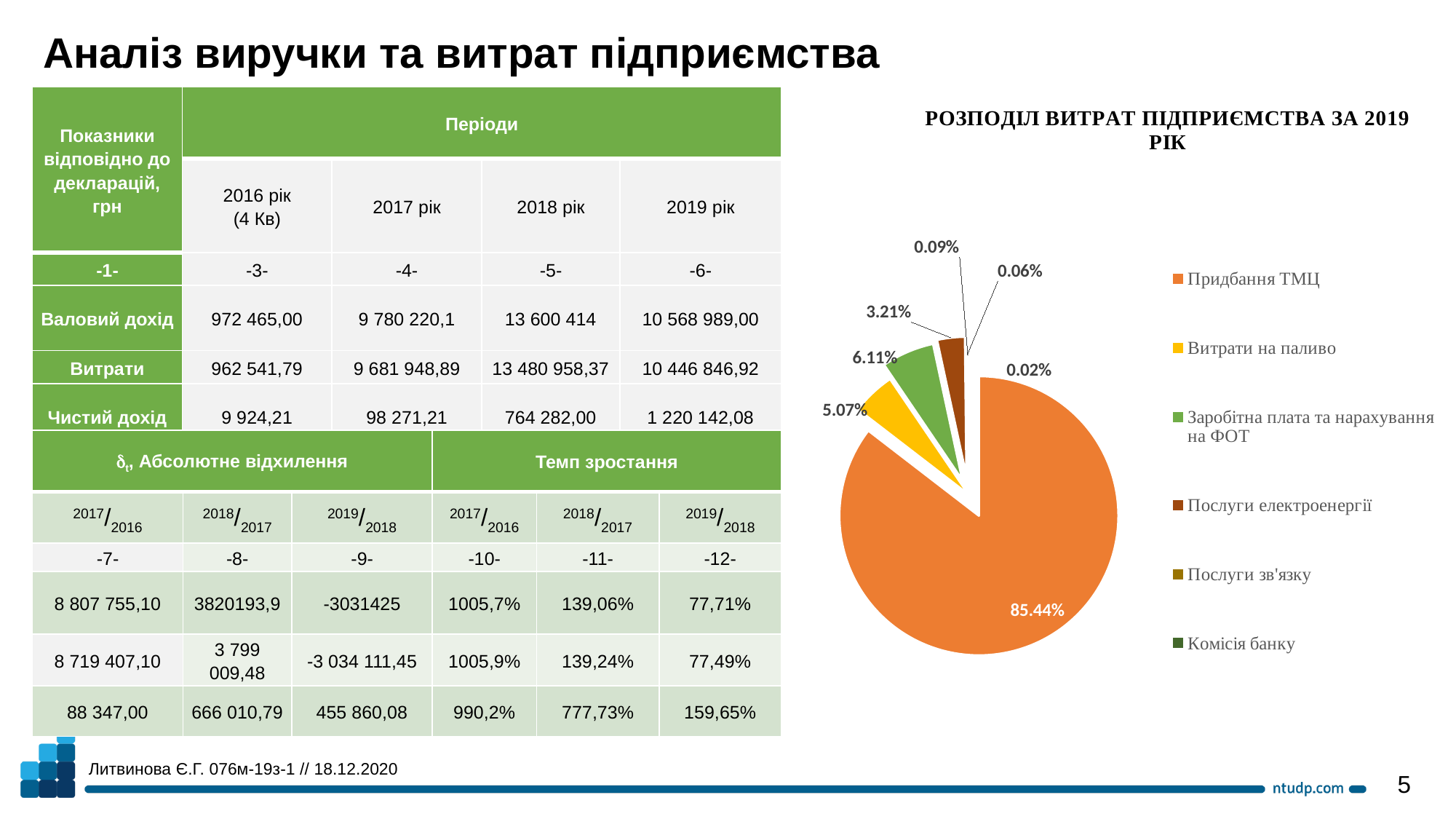
What kind of chart is shown on the right side of the slide? pie chart In the pie chart, what is the difference in percentage points between Заробітна плата та нарахування на ФОТ and Витрати на паливо? 1.04% What colour is the largest slice of the pie chart? orange What is the smallest percentage labelled on the pie chart? 0.02% In the pie chart, what share is shown for Послуги електроенергії? 3.21% In the pie chart, what share is shown for Заробітна плата та нарахування на ФОТ? 6.11% What is the title of the pie chart? РОЗПОДІЛ ВИТРАТ ПІДПРИЄМСТВА ЗА 2019 РІК In the pie chart, which is larger: Заробітна плата та нарахування на ФОТ or Витрати на паливо? Заробітна плата та нарахування на ФОТ In the pie chart, what share is shown for Придбання ТМЦ? 85.44% In the pie chart, what share is shown for Витрати на паливо? 5.07% How many entries does the legend of the pie chart list? 6 Which category has the largest slice in the pie chart? Придбання ТМЦ